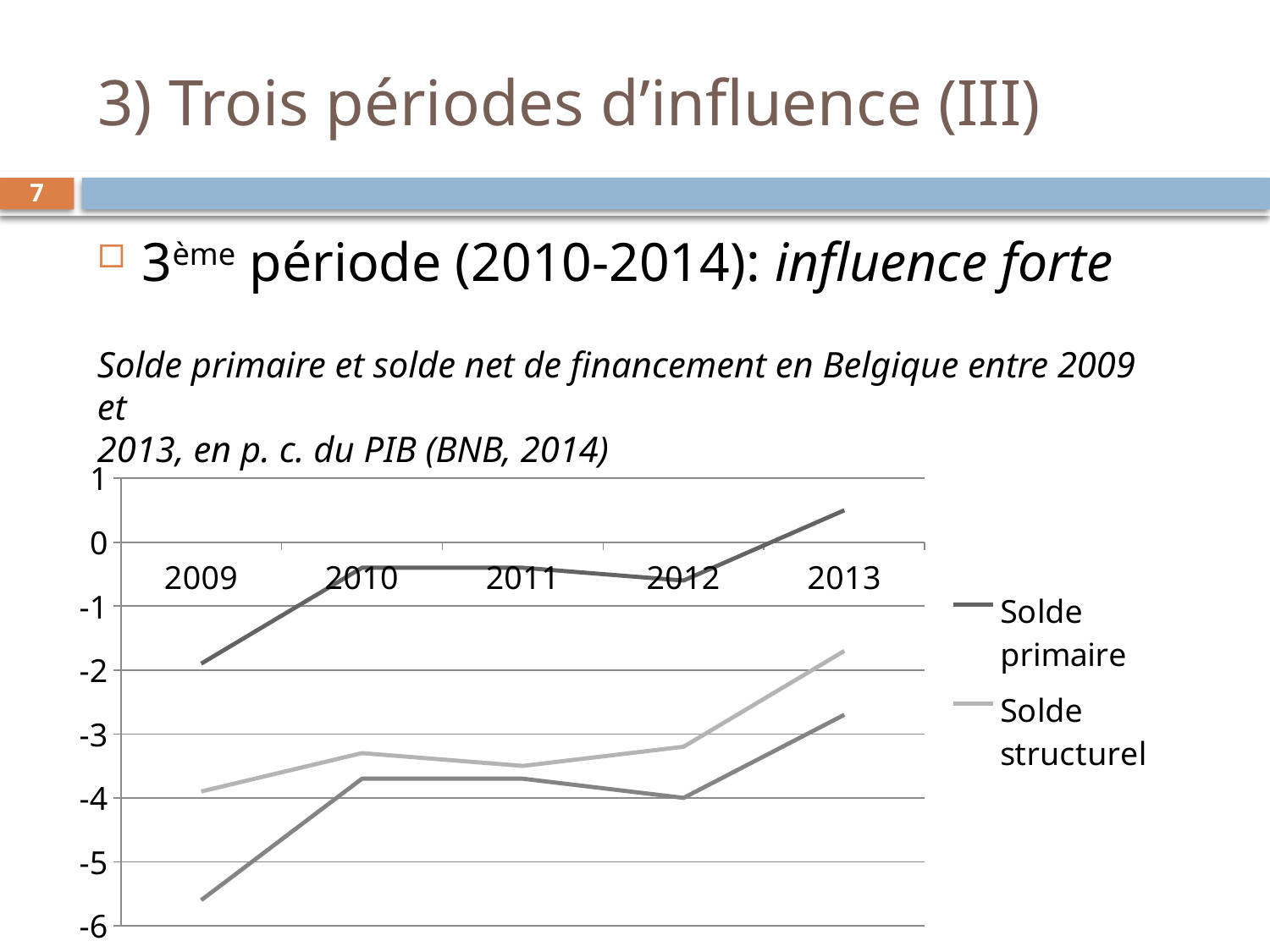
In 2013, which is larger: Solde primaire or Solde structurel? Solde primaire Is the value of Solde structurel in 2013 greater or less than -2? greater Does Solde primaire rise or fall between 2009 and 2010? rise In which year is Solde primaire at its highest? 2013 In which year is Solde structurel at its lowest? 2009 In which year is Solde primaire at its lowest? 2009 How many series does the chart's legend list? 2 What kind of chart is shown on the slide? line chart Is the value of Solde primaire in 2013 greater or less than 0? greater Is the value of Solde primaire in 2009 greater or less than -1? less How many years are plotted along the x axis of the chart? 5